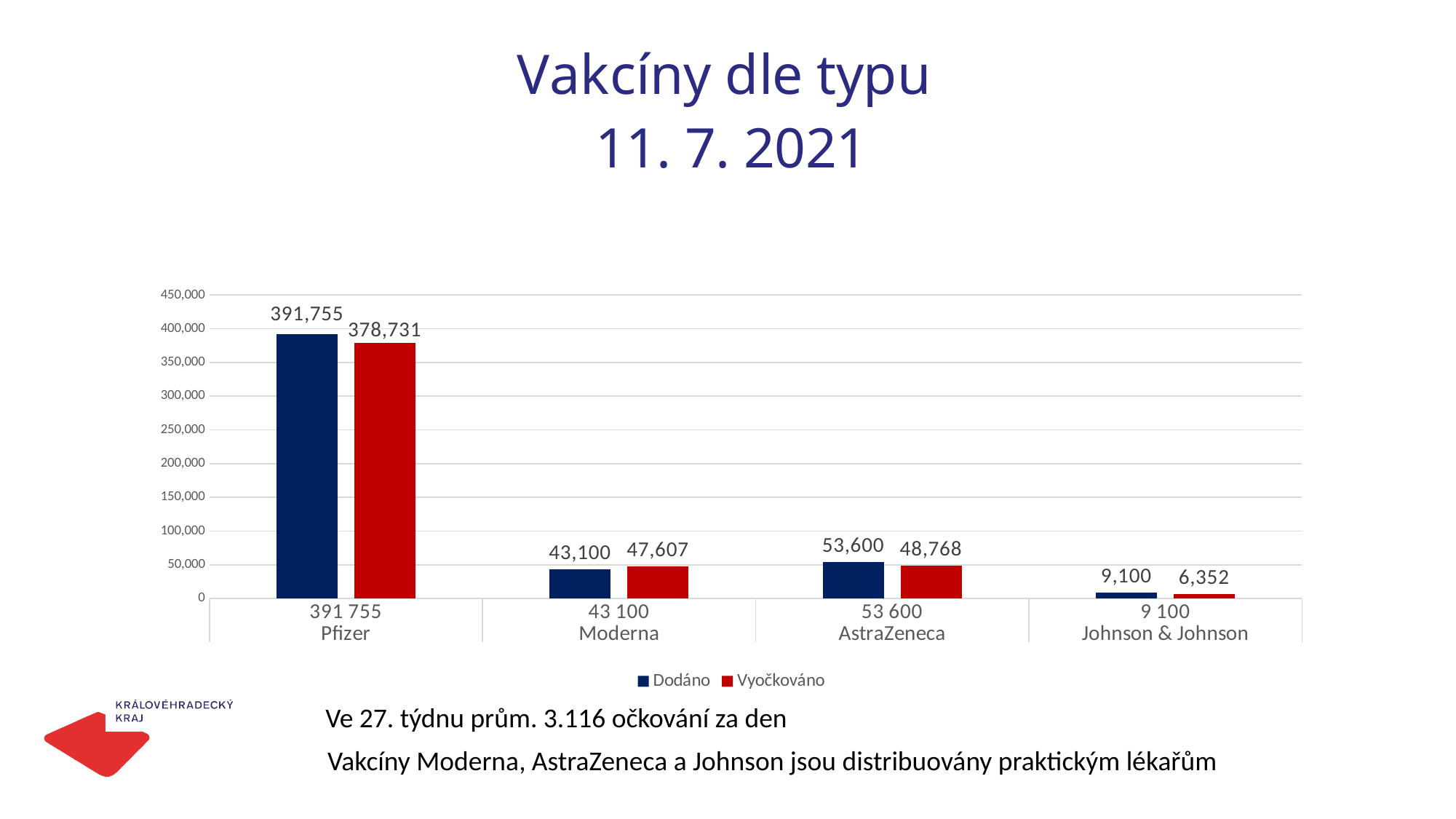
What is the Vyočkováno value for Moderna? 47,607 What is the difference between the Dodáno and Vyočkováno values for Pfizer? 13,024 How many vaccine types are shown on the x axis? 4 What kind of chart is shown on the slide? Bar chart Which vaccine has the lowest Vyočkováno value? Johnson & Johnson What is the Vyočkováno value for Johnson & Johnson? 6,352 What is the Dodáno value for AstraZeneca? 53,600 Which vaccine has the highest Dodáno value? Pfizer What is the Dodáno value for Pfizer? 391,755 For Moderna, which is larger: Dodáno or Vyočkováno? Vyočkováno What is the difference between the Dodáno values for AstraZeneca and Moderna? 10,500 How many series does the legend list? 2